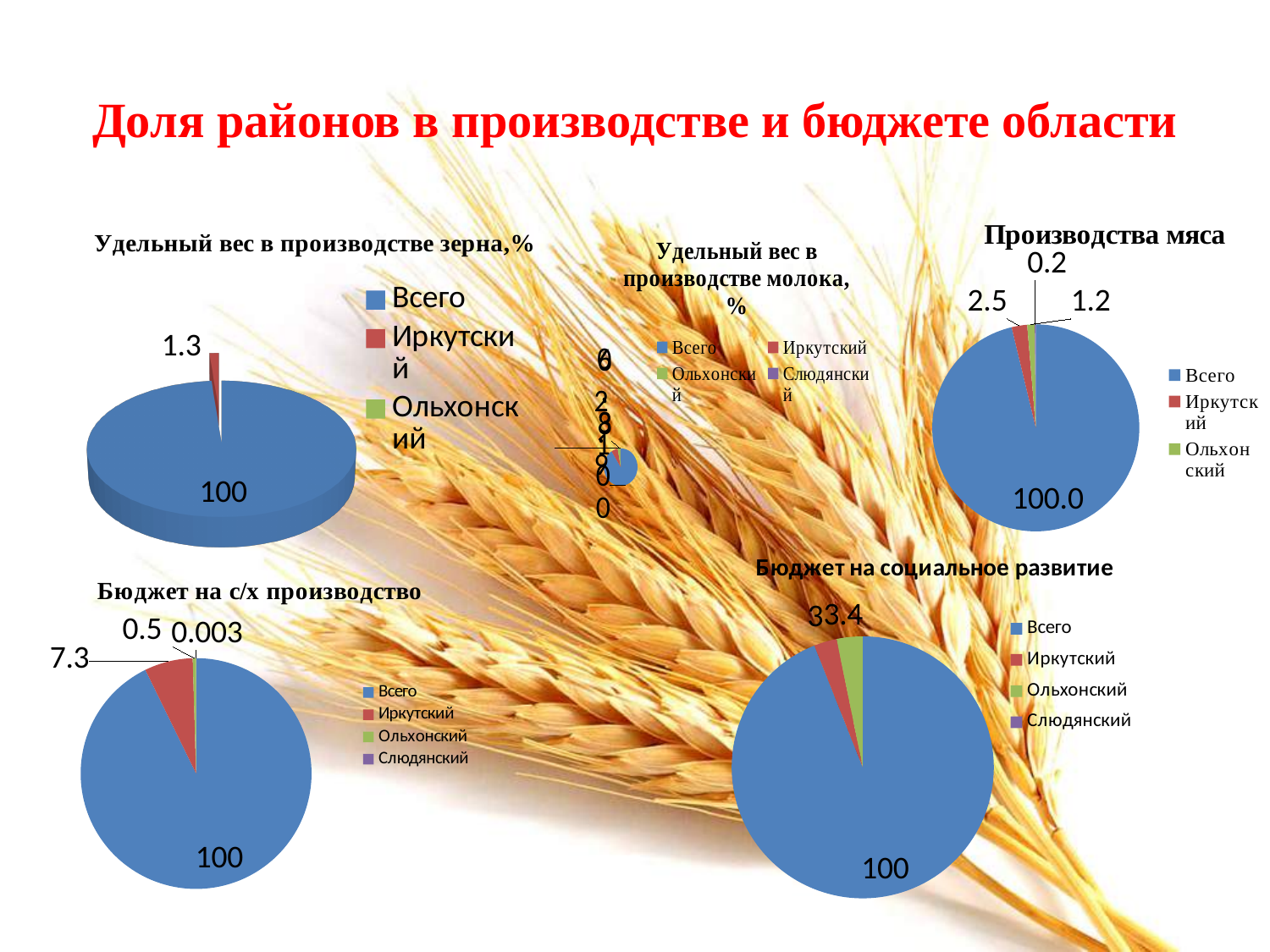
In the chart "Производства мяса", which slice is the largest? Всего How many entries does the legend of "Удельный вес в производстве зерна,%" list? 3 In the chart "Бюджет на с/х производство", what is the value for Слюдянский? 0.003 What kind of chart is "Удельный вес в производстве зерна,%"? pie chart In the chart "Производства мяса", what is the value for Иркутский? 2.5 In the chart "Удельный вес в производстве зерна,%", what is the value for Иркутский? 1.3 How many entries does the legend of "Бюджет на социальное развитие" list? 4 How many charts are shown on the slide? 5 In the chart "Бюджет на с/х производство", what is the difference between the values for Всего and Иркутский? 92.7 In the chart "Бюджет на с/х производство", what is the value for Иркутский? 7.3 In the chart "Удельный вес в производстве зерна,%", what is the value for Всего? 100 In the chart "Производства мяса", what is the value for Всего? 100.0